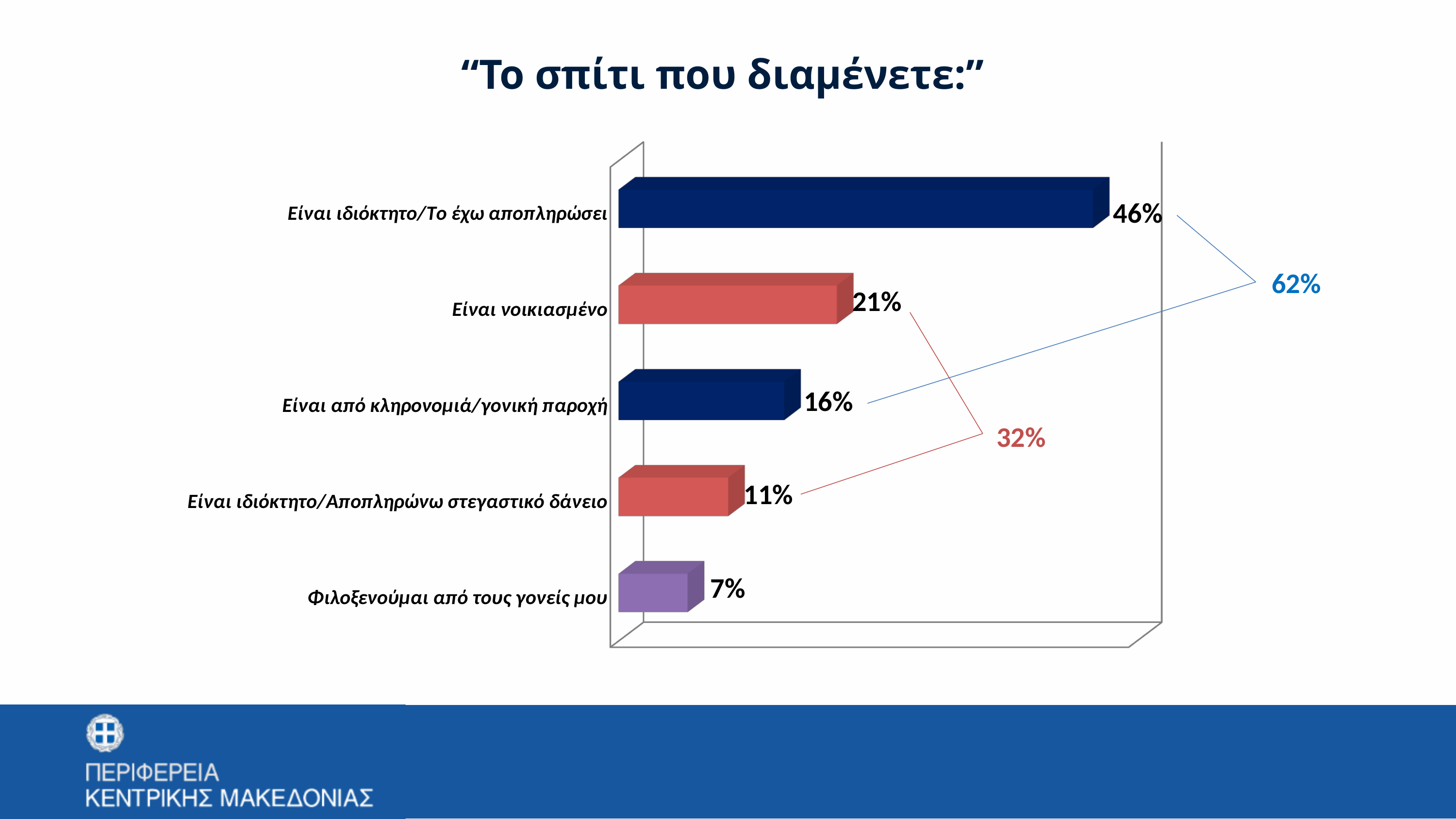
What is the difference between the percentages for "Είναι ιδιόκτητο/Το έχω αποπληρώσει" and "Είναι νοικιασμένο"? 25% Which is larger: the percentage for "Είναι από κληρονομιά/γονική παροχή" or for "Είναι ιδιόκτητο/Αποπληρώνω στεγαστικό δάνειο"? Είναι από κληρονομιά/γονική παροχή What is the title of the chart? "Το σπίτι που διαμένετε:" What percentage is shown for "Φιλοξενούμαι από τους γονείς μου"? 7% What percentage is shown for "Είναι ιδιόκτητο/Το έχω αποπληρώσει"? 46% How many categories are shown in the chart? 5 Which category has the lowest percentage? Φιλοξενούμαι από τους γονείς μου What combined percentage is annotated in blue for the two dark blue bars (46% and 16%)? 62% What percentage is shown for "Είναι νοικιασμένο"? 21% What type of chart is shown on the slide? Bar chart What percentage is shown for "Είναι ιδιόκτητο/Αποπληρώνω στεγαστικό δάνειο"? 11% Which category has the highest percentage? Είναι ιδιόκτητο/Το έχω αποπληρώσει